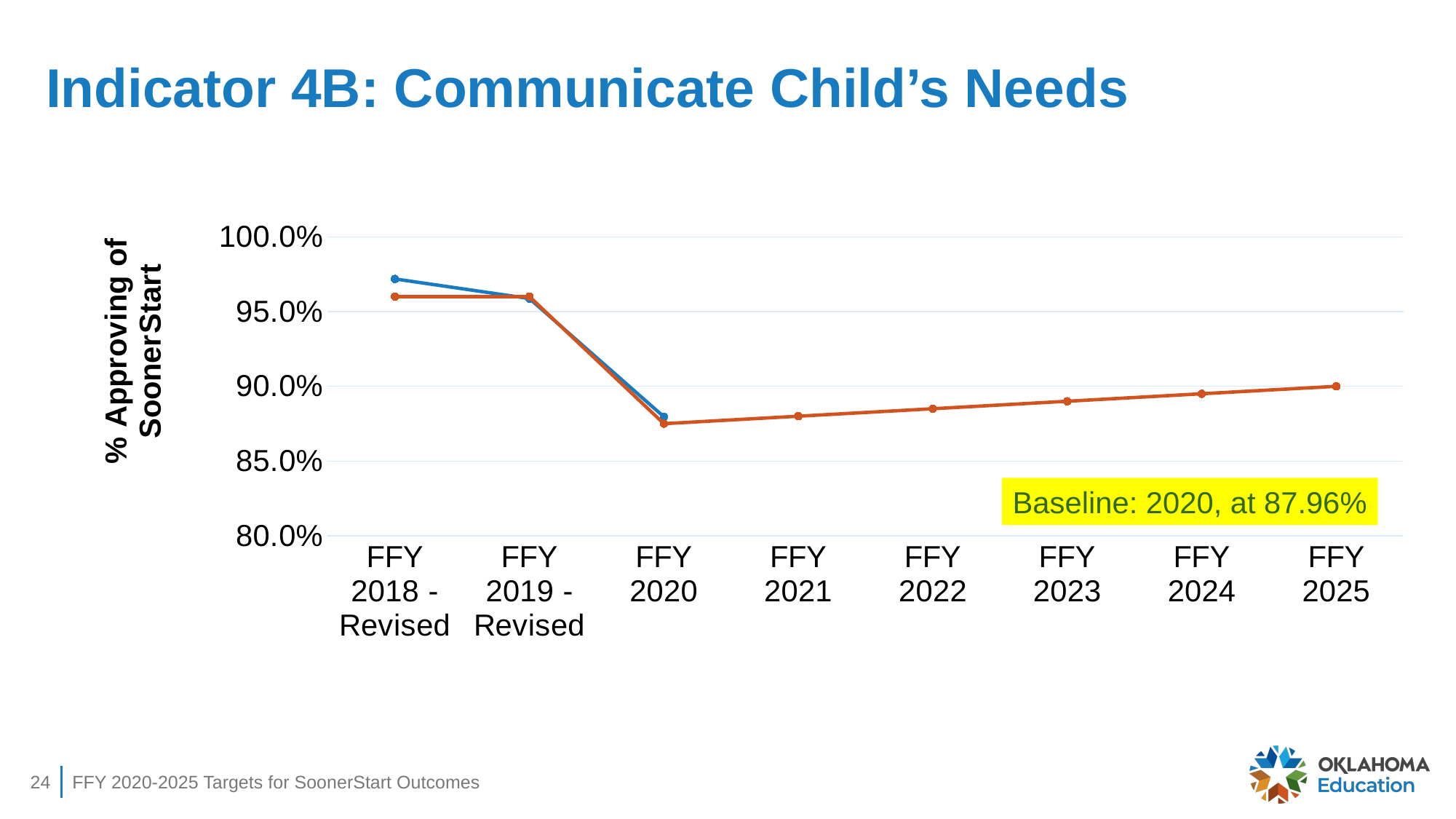
Is the value for FFY 2019 - Revised greater or less than 95.0%? greater Is the value for FFY 2022 greater or less than 90.0%? less Do the values rise or fall from FFY 2020 to FFY 2025? rise Which is larger, the value for FFY 2019 - Revised or the value for FFY 2023? FFY 2019 - Revised Which FFY category has the highest value on the chart? FFY 2018 - Revised What kind of chart is shown on the slide? line chart How many FFY categories are shown on the x axis? 8 Which FFY category has the lowest value on the chart? FFY 2020 What is the title of the y axis? % Approving of SoonerStart Is the value for FFY 2020 greater or less than 90.0%? less What baseline value does the highlighted annotation give for 2020? 87.96% What is the title of the slide? Indicator 4B: Communicate Child's Needs